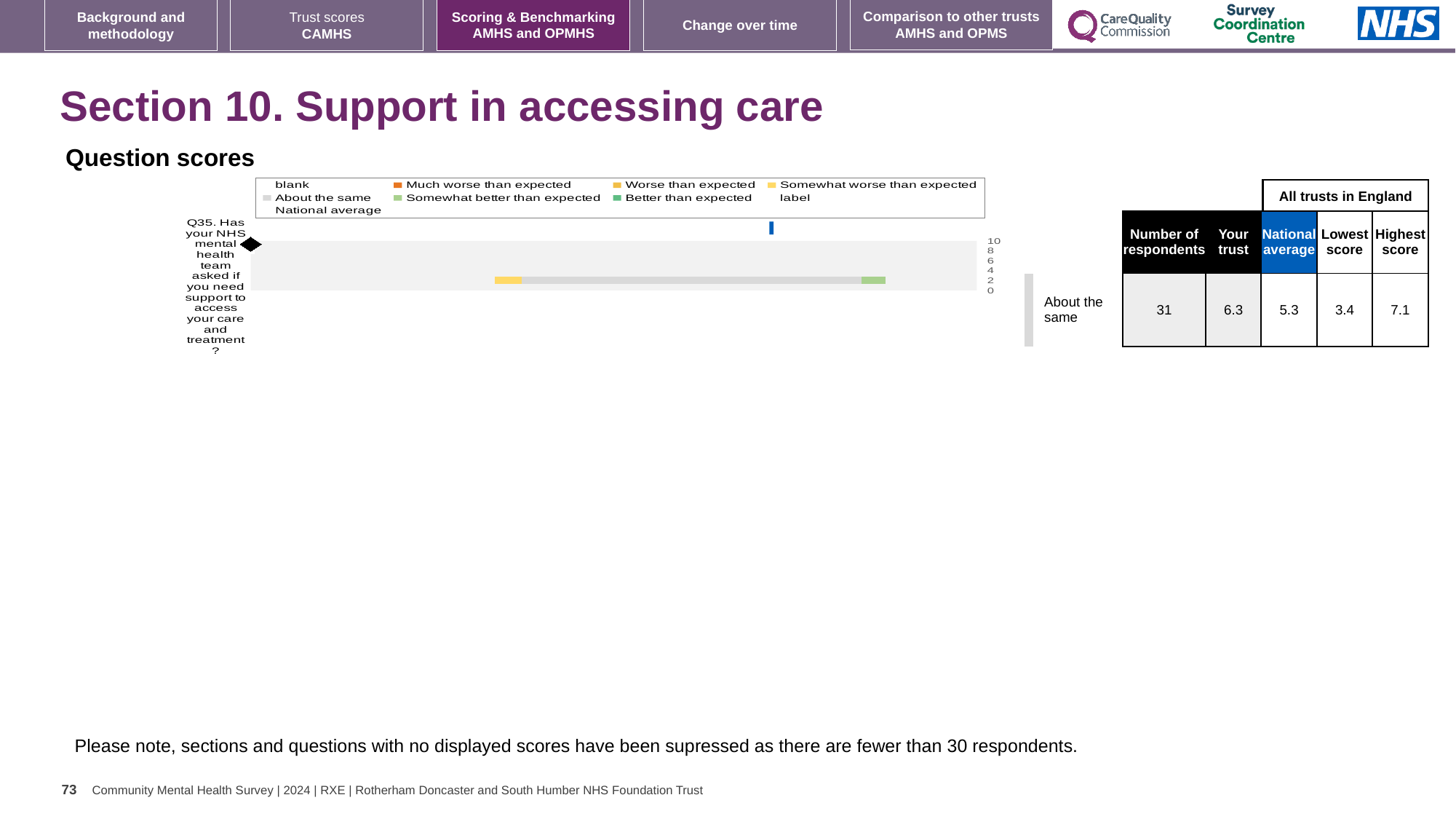
How many respondents answered Q35? 31 What is the difference between the trust's score and the national average for Q35? 1.0 Which question is plotted in the Question scores chart? Q35. Has your NHS mental health team asked if you need support to access your care and treatment? What is the national average score for Q35? 5.3 What benchmark category is shown for Q35? About the same What kind of chart is shown under 'Question scores'? bar chart Is the trust's score for Q35 higher or lower than the national average? higher How many questions are plotted in the Question scores chart? 1 What is the lowest score among all trusts in England for Q35? 3.4 What is the 'Your trust' score for Q35? 6.3 What is the difference between the highest and lowest scores for Q35 across all trusts in England? 3.7 What is the highest score among all trusts in England for Q35? 7.1